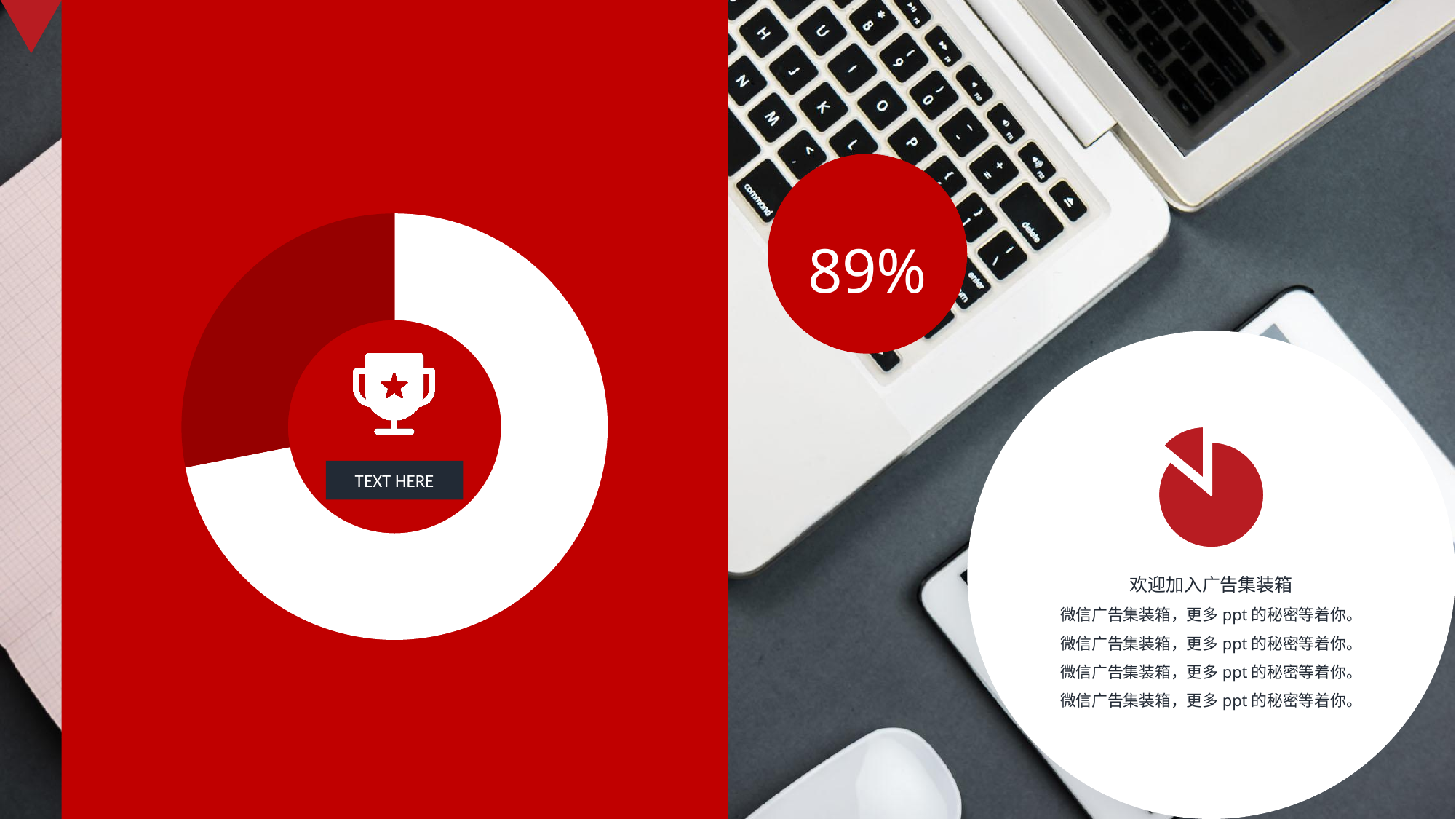
How many segments does the doughnut chart on the left have? 2 What text is shown in the dark box at the centre of the doughnut chart? TEXT HERE What kind of chart is shown on the left side of the slide? Doughnut chart Which segment of the doughnut chart is the smallest? The dark red segment In the doughnut chart, which segment is larger, the white one or the dark red one? The white one What colour is the larger segment of the doughnut chart? White